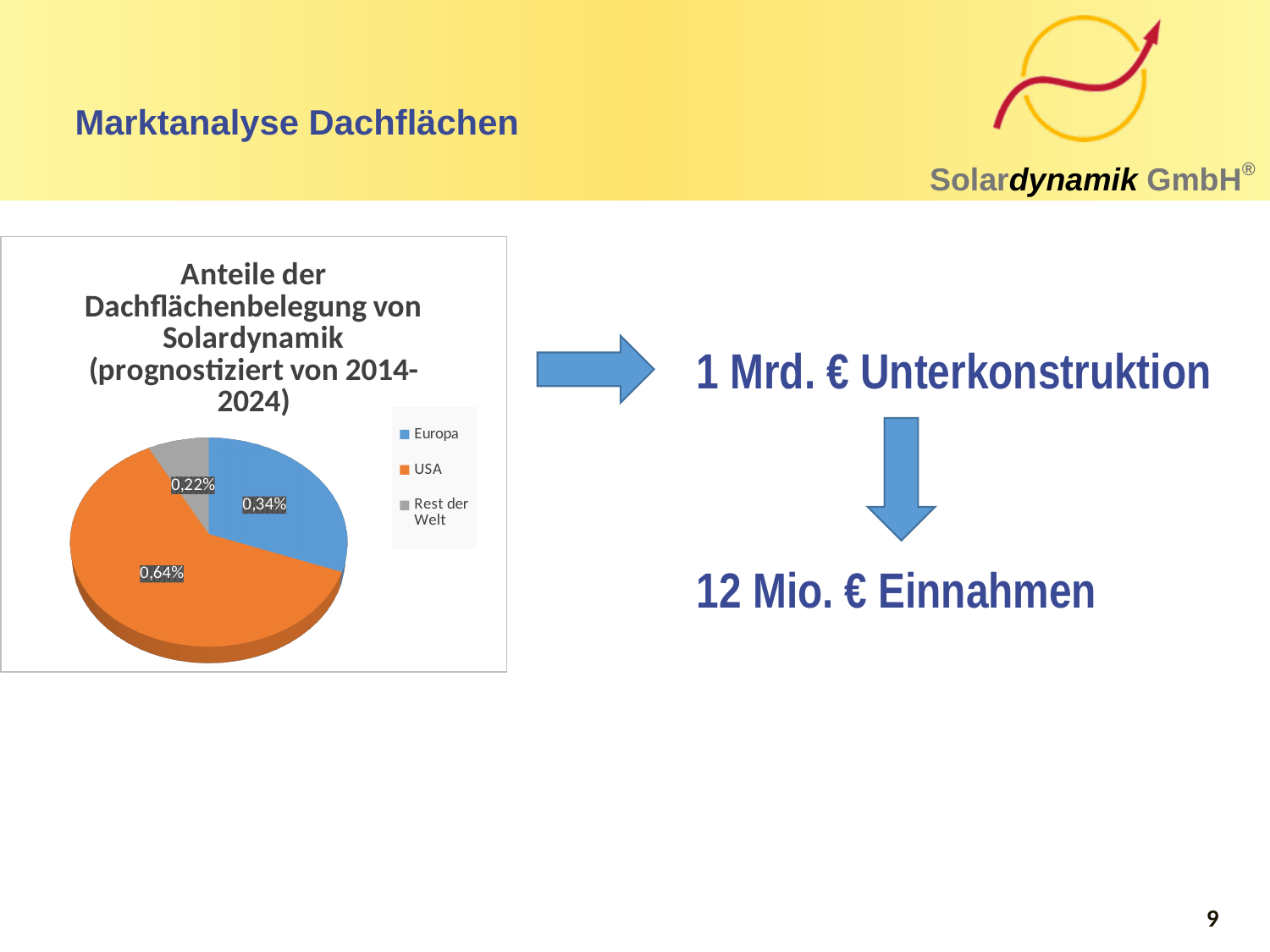
What is the value shown for Europa in the pie chart? 0,34% What is the title of the pie chart? Anteile der Dachflächenbelegung von Solardynamik (prognostiziert von 2014-2024) Which category has the largest slice in the pie chart? USA Which colour represents USA in the pie chart? orange What is the value shown for USA in the pie chart? 0,64% What kind of chart is shown on the slide? pie chart Which is larger in the pie chart, Europa or Rest der Welt? Europa How many slices does the pie chart have? 3 Which category has the smallest slice in the pie chart? Rest der Welt How many entries does the legend of the pie chart list? 3 What is the value shown for Rest der Welt in the pie chart? 0,22%